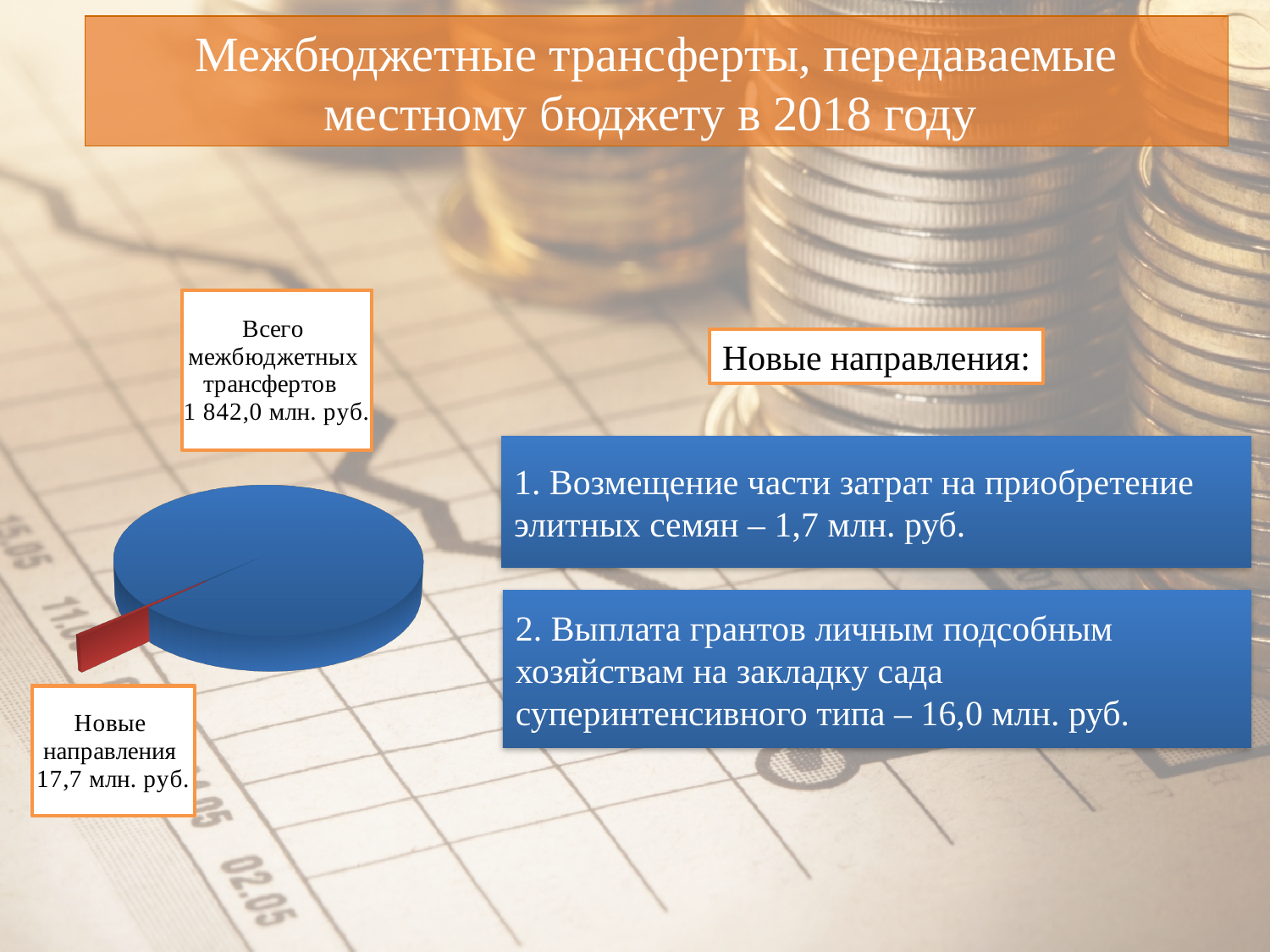
What value is given for "Новые направления" next to the pie chart? 17,7 млн. руб. Is the value for "Новые направления" greater or less than 100 млн. руб.? less What is the title of the slide containing the pie chart? Межбюджетные трансферты, передаваемые местному бюджету в 2018 году How many slices does the pie chart have? 2 What kind of chart is shown on the slide? pie chart What is the total of intergovernmental transfers ("Всего межбюджетных трансфертов") shown above the pie chart? 1 842,0 млн. руб. Which slice of the pie chart is larger, the blue one or the red one? the blue one What colour is the slice representing "Новые направления" in the pie chart? red